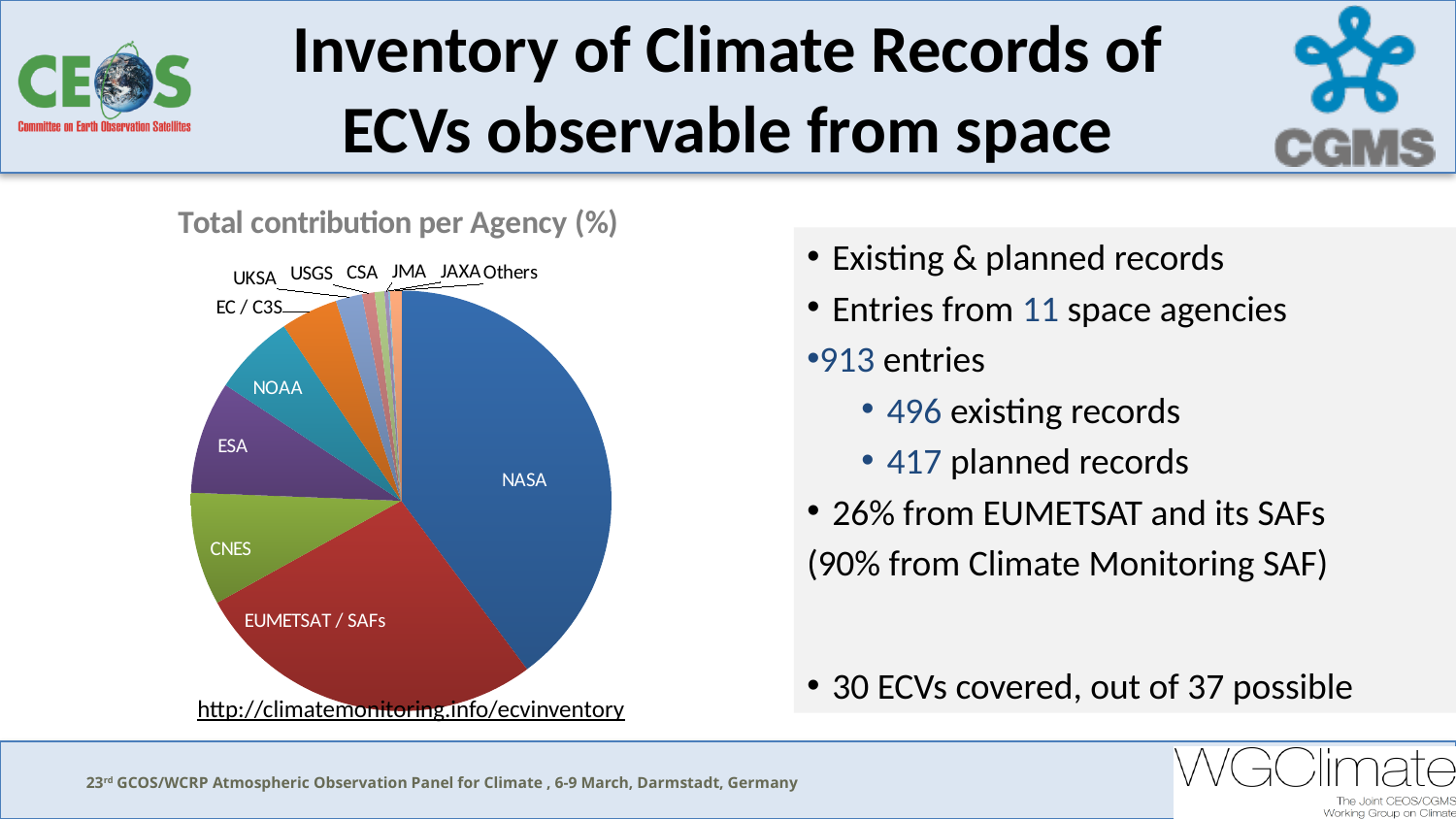
Which slice is larger, CNES or EC / C3S? CNES How many slices does the pie chart have? 12 What kind of chart is shown on the slide? pie chart Which slice is larger, NOAA or UKSA? NOAA Which slice is larger, ESA or NOAA? ESA What is the title of the chart? Total contribution per Agency (%) Which agency has the largest slice of the pie chart? NASA Which agency has the second-largest slice of the pie chart? EUMETSAT / SAFs